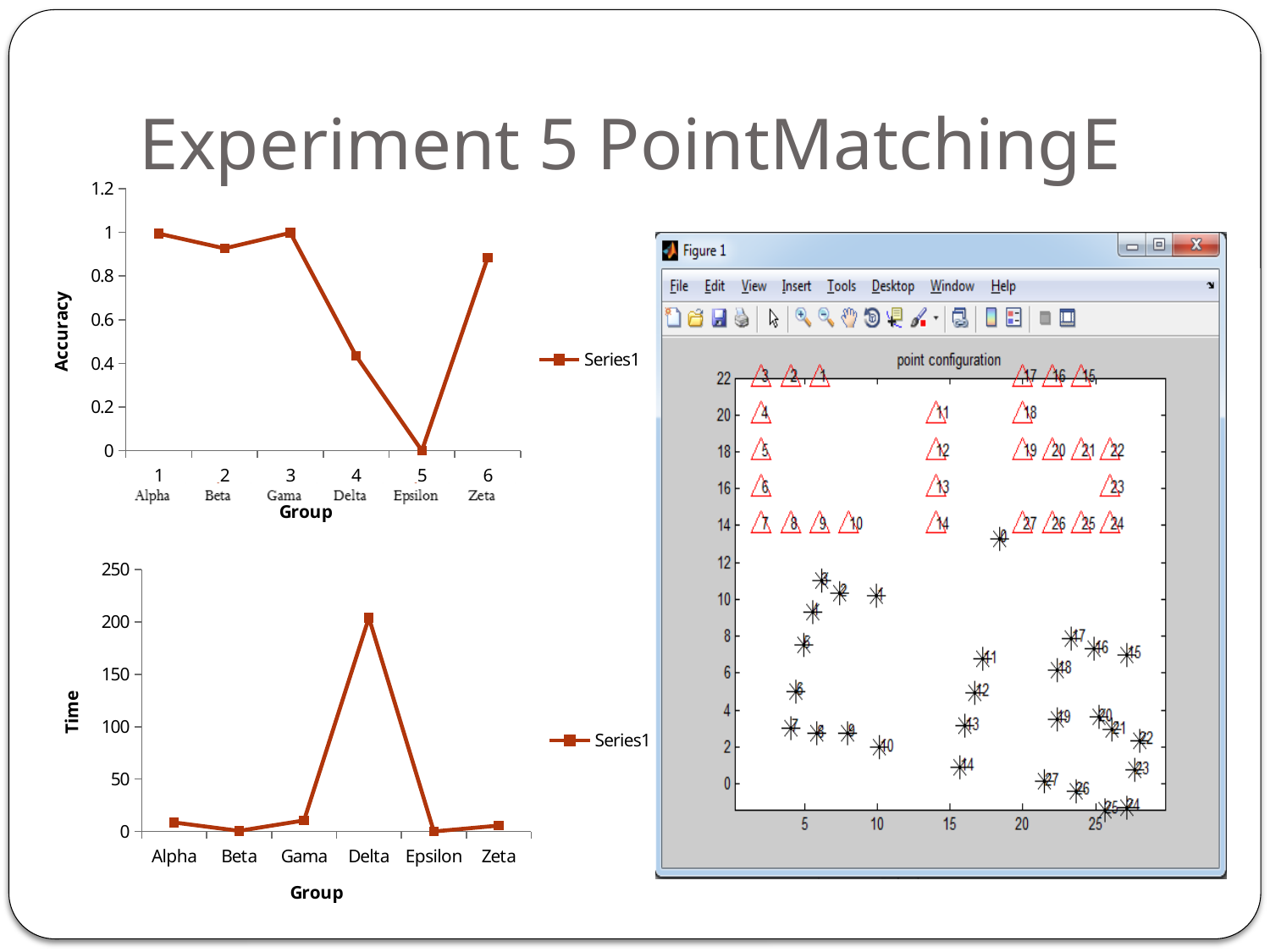
In the Accuracy chart, is the value for Delta greater or less than 0.6? less How many series does the legend of the Accuracy chart list? 1 In the Time chart, is the value for Alpha greater or less than 50? less In the Accuracy chart, which has the higher accuracy, Delta or Zeta? Zeta What kind of chart is the Time chart? Line chart In the Time chart, is the value for Delta greater or less than 150? greater In the Accuracy chart, do the values rise or fall from Gama to Epsilon? Fall In the Accuracy chart, which group has the lowest accuracy? Epsilon In the Time chart, which group has the highest time? Delta How many groups are plotted on the x axis of the Time chart? 6 In the Time chart, which has the higher time, Gama or Delta? Delta